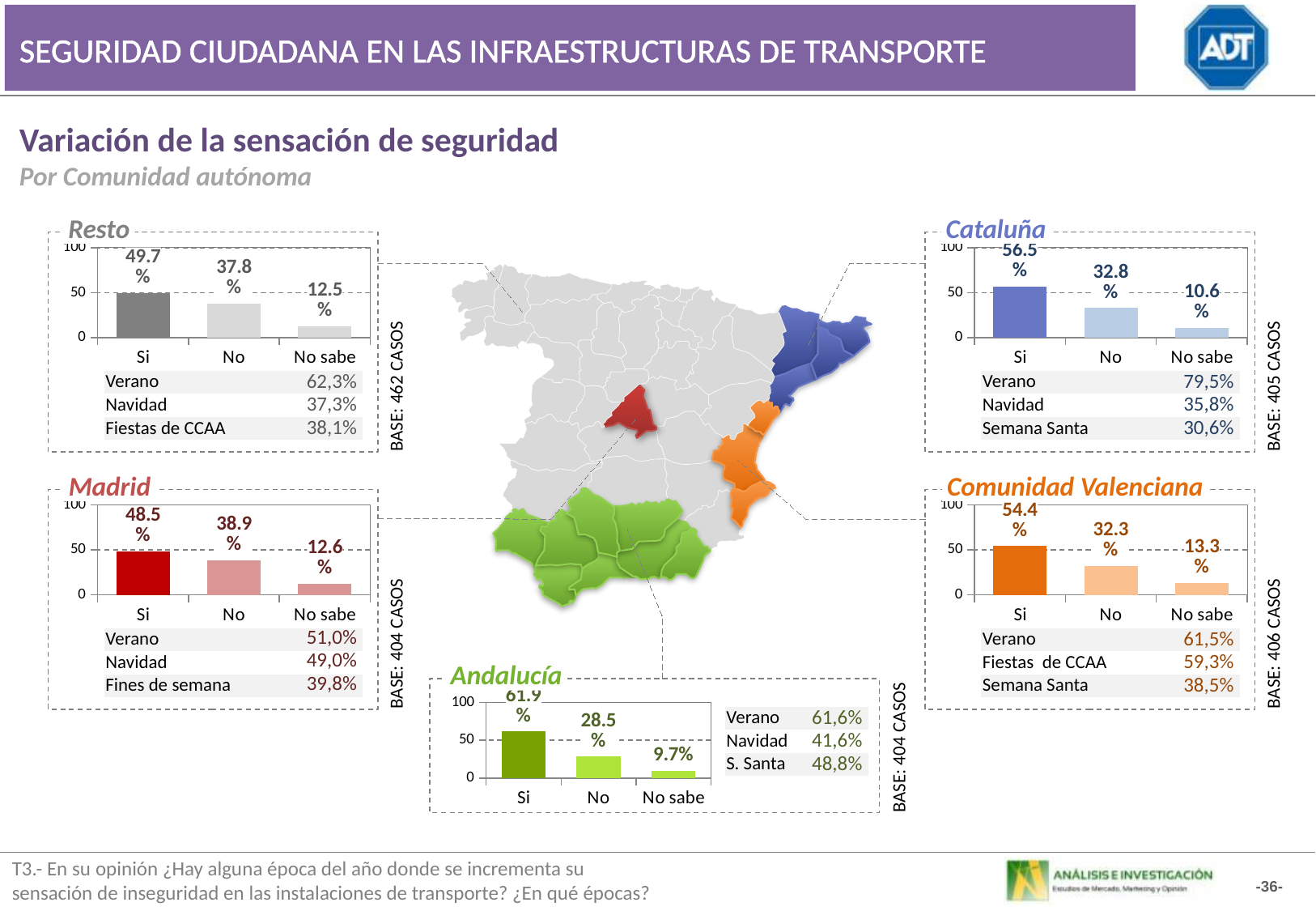
In the Andalucía chart, is the value for "Si" greater or less than 50? greater In the Andalucía chart, what is the difference between the "Si" and "No" values? 33.4% In the Comunidad Valenciana chart, what is the value for "Si"? 54.4% How many categories does the Comunidad Valenciana chart show? 3 In the Cataluña chart, which category has the lowest value? No sabe What kind of chart is the Resto chart? bar chart In the Andalucía chart, what is the value for "No sabe"? 9.7% In the Madrid chart, which is larger, the value for "Si" or the value for "No"? Si How many bar charts are shown on the slide? 5 In the Resto chart, which category has the highest value? Si In the Cataluña chart, what is the value for "Si"? 56.5% In the Madrid chart, what is the value for "No"? 38.9%